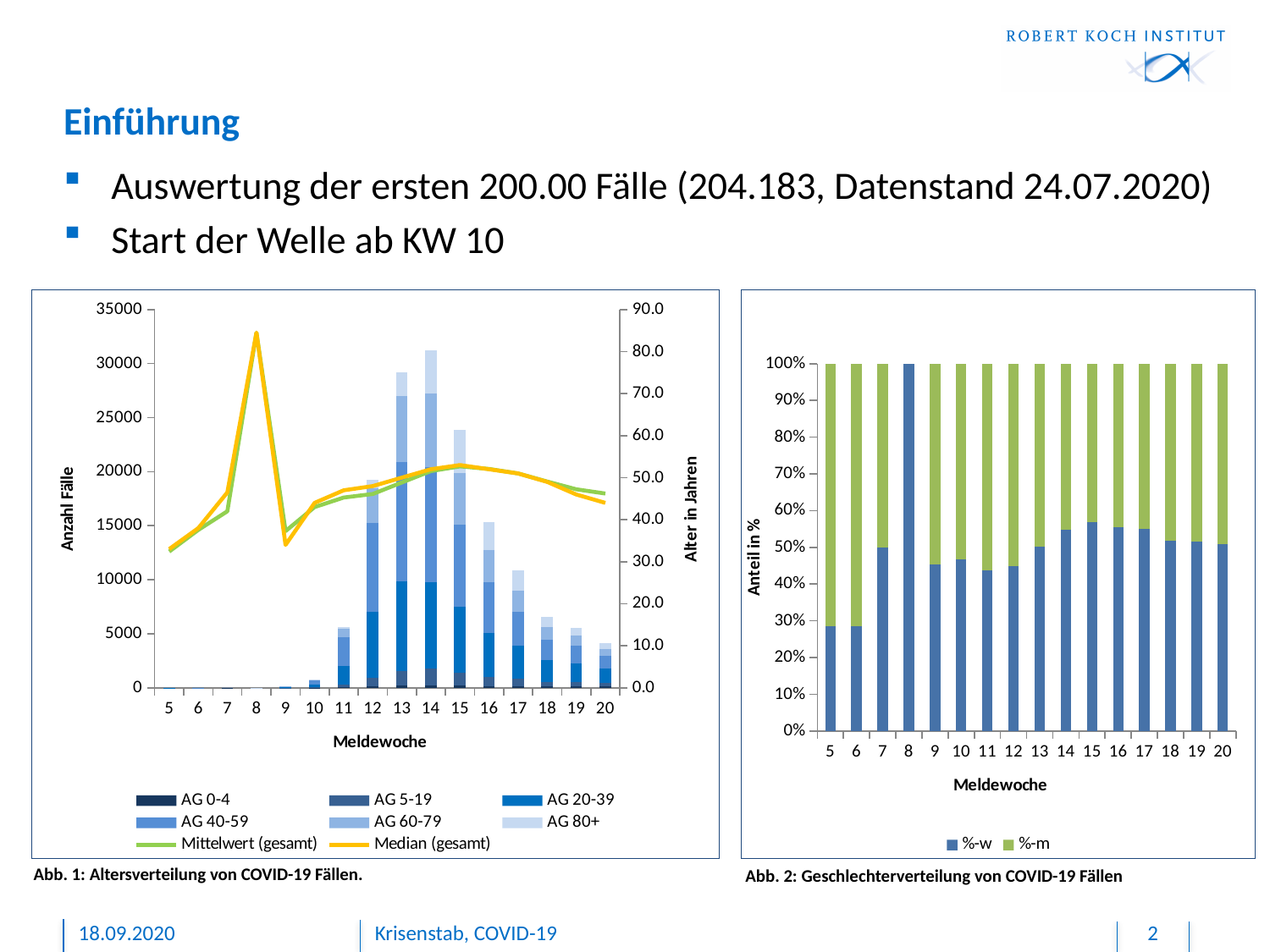
In Abb. 2 (the right chart), which has the larger %-w share: Meldewoche 11 or Meldewoche 15? Meldewoche 15 In Abb. 2 (the right chart), is the %-w share for Meldewoche 5 greater or less than 40%? less In Abb. 1 (the left chart), is the total height of the stacked bar for Meldewoche 14 greater or less than 25000? greater How many series does the legend of Abb. 2 (the right chart) list? 2 In Abb. 1 (the left chart), which Meldewoche has the tallest stacked bar? 14 In Abb. 1 (the left chart), how many Meldewoche categories are shown on the x axis? 16 What is the title of the right-hand vertical axis in Abb. 1 (the left chart)? Alter in Jahren In Abb. 1 (the left chart), does the Median (gesamt) line rise or fall from Meldewoche 15 to Meldewoche 20? fall How many series does the legend of Abb. 1 (the left chart) list? 8 In Abb. 1 (the left chart), is the Median (gesamt) value at Meldewoche 8 greater or less than 80.0? greater What kind of chart is Abb. 2 (the right chart, Geschlechterverteilung von COVID-19 Fällen)? bar chart In Abb. 2 (the right chart), which Meldewoche has the highest %-w share? 8